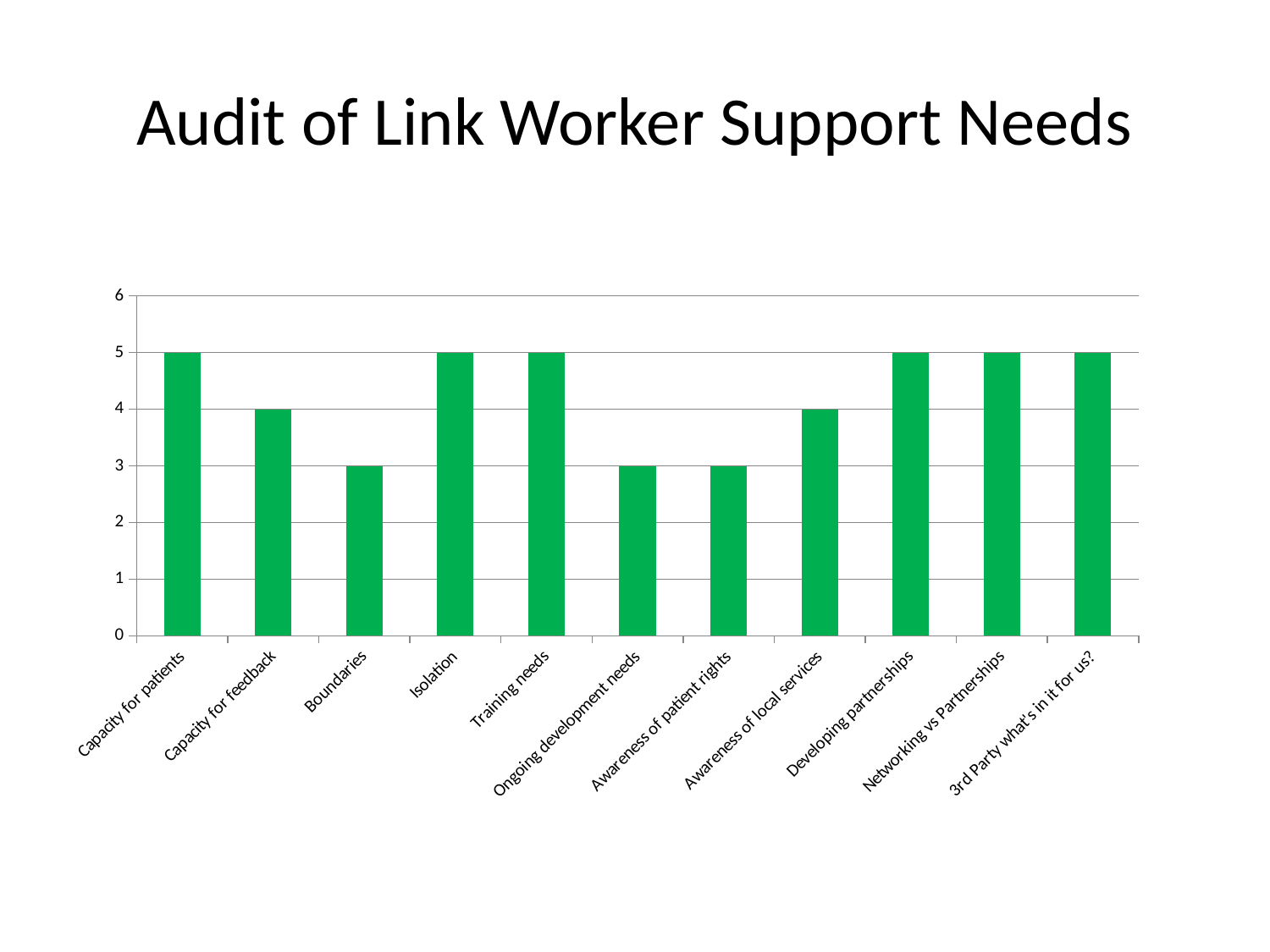
What is the value for Boundaries? 3 What is the title of the chart? Audit of Link Worker Support Needs What is the value for Awareness of patient rights? 3 What is the difference between the values for Capacity for patients and Boundaries? 2 What colour are the bars in the chart? green What type of chart is shown on the slide? bar chart What is the value for Awareness of local services? 4 Is the value for Developing partnerships greater or less than 4? greater How many categories are shown on the x axis? 11 What is the value for Capacity for feedback? 4 What is the value for Isolation? 5 Which is larger, the value for Training needs or the value for Ongoing development needs? Training needs